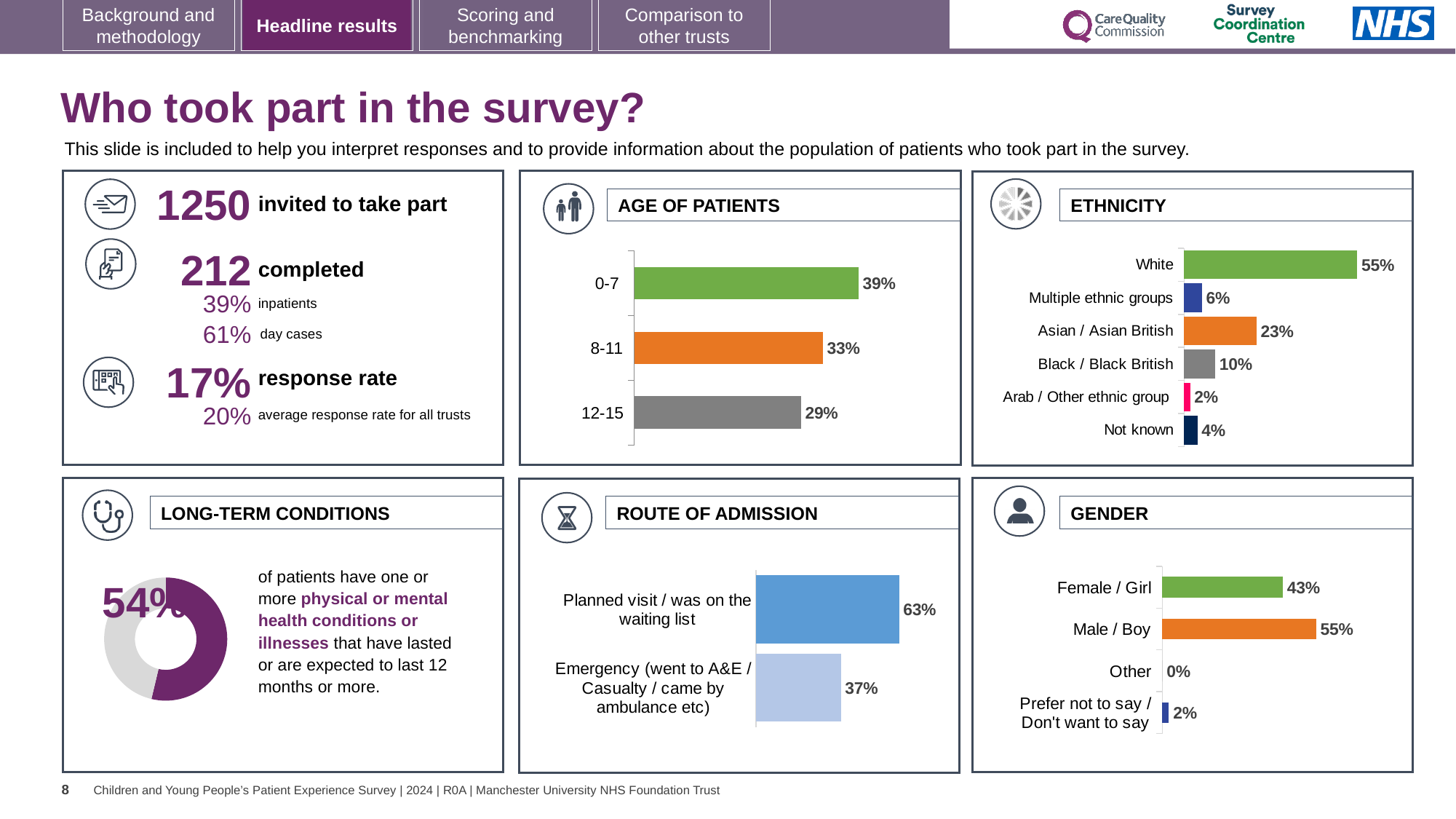
In the AGE OF PATIENTS chart, what percentage of patients were aged 0-7? 39% In the AGE OF PATIENTS chart, which age group has the lowest percentage? 12-15 In the GENDER chart, what is the difference between the Male / Boy and Female / Girl percentages? 12% In the ROUTE OF ADMISSION chart, which route has the larger percentage: Planned visit / was on the waiting list or Emergency? Planned visit / was on the waiting list In the GENDER chart, what percentage of patients were Male / Boy? 55% In the ETHNICITY chart, what percentage of patients were Asian / Asian British? 23% In the ETHNICITY chart, what is the difference between the White and Black / Black British percentages? 45% What kind of chart is used in the LONG-TERM CONDITIONS panel? Doughnut chart In the ROUTE OF ADMISSION chart, what percentage of patients came via Emergency (went to A&E / Casualty / came by ambulance etc)? 37% In the ETHNICITY chart, which ethnic group has the highest percentage? White In the LONG-TERM CONDITIONS chart, what percentage of patients have one or more long-term conditions? 54% How many categories are shown in the ETHNICITY chart? 6